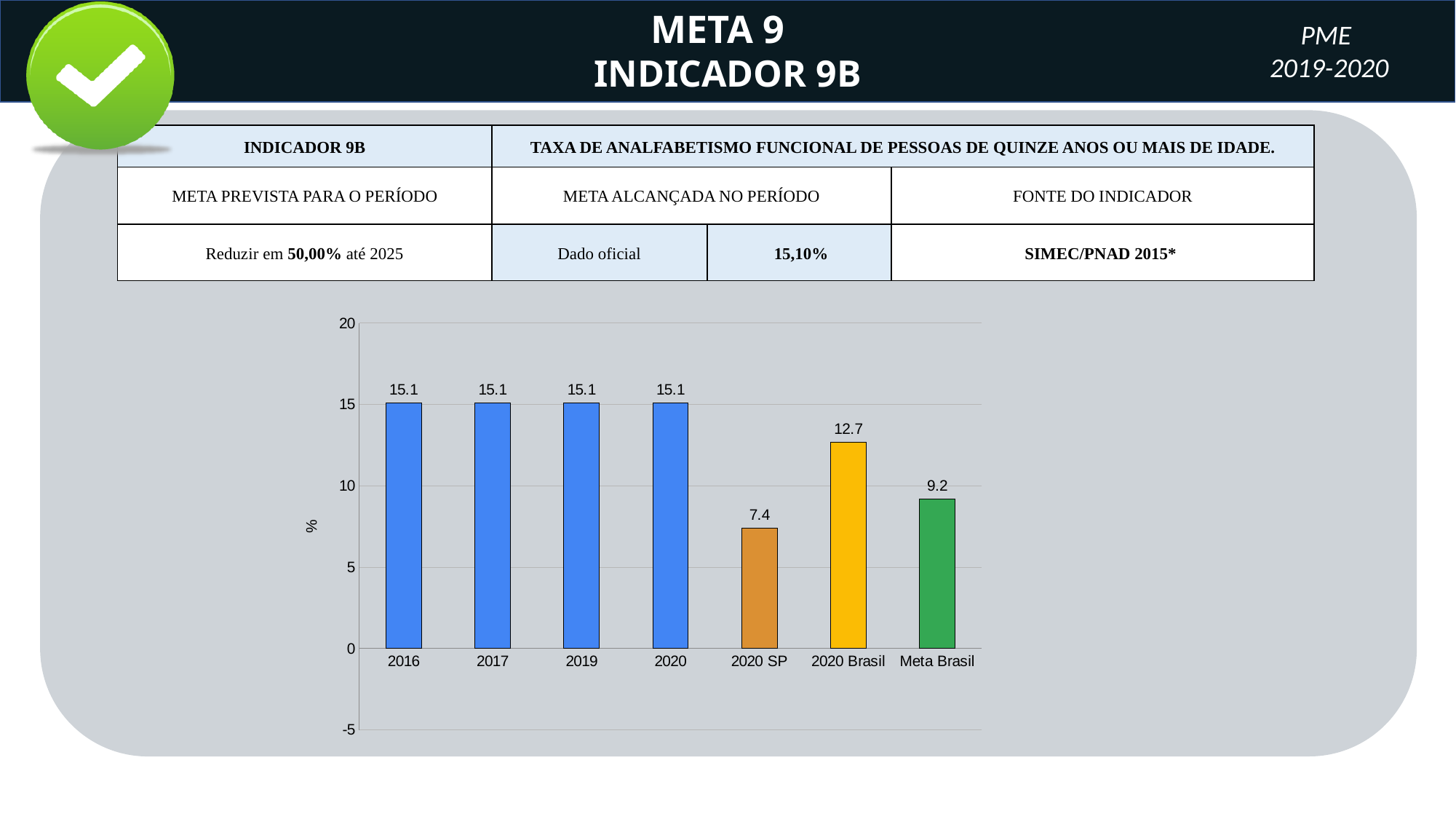
What is the value for 2016? 15.1 Is the value for 2020 SP greater or less than 10? less What is the value for 2020 SP? 7.4 What is the value for 2020 Brasil? 12.7 How many bars are shown in the chart? 7 What is the label on the vertical axis of the chart? % What kind of chart is shown on the slide? bar chart What is the value for Meta Brasil? 9.2 What is the difference between the values for 2020 Brasil and Meta Brasil? 3.5 Which is larger, the value for 2020 Brasil or the value for Meta Brasil? 2020 Brasil Which category has the lowest value? 2020 SP What is the difference between the values for 2020 and 2020 SP? 7.7